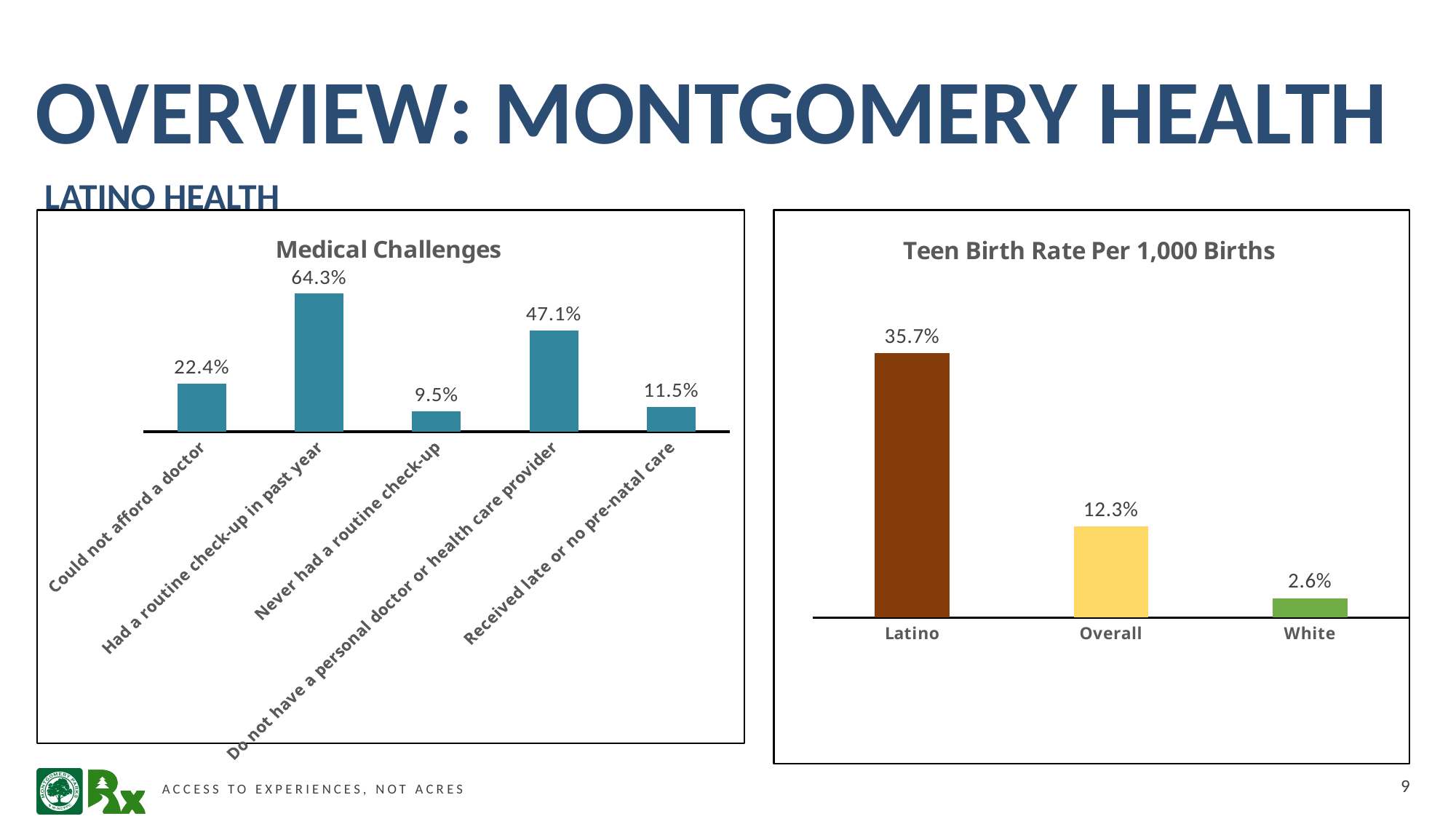
What kind of chart is the Teen Birth Rate Per 1,000 Births chart? Bar chart How many categories are shown in the Medical Challenges chart? 5 In the Medical Challenges chart, which category has the lowest value? Never had a routine check-up In the Teen Birth Rate Per 1,000 Births chart, which category has the highest value? Latino In the Medical Challenges chart, what is the difference between 'Do not have a personal doctor or health care provider' and 'Could not afford a doctor'? 24.7% In the Teen Birth Rate Per 1,000 Births chart, what is the value for Overall? 12.3% In the Teen Birth Rate Per 1,000 Births chart, which is larger, Overall or White? Overall In the Medical Challenges chart, which category has the highest value? Had a routine check-up in past year In the Medical Challenges chart, what is the value for 'Had a routine check-up in past year'? 64.3% In the Teen Birth Rate Per 1,000 Births chart, do the values rise or fall from left to right? Fall In the Medical Challenges chart, what is the value for 'Received late or no pre-natal care'? 11.5% In the Teen Birth Rate Per 1,000 Births chart, what is the difference between Latino and White? 33.1%